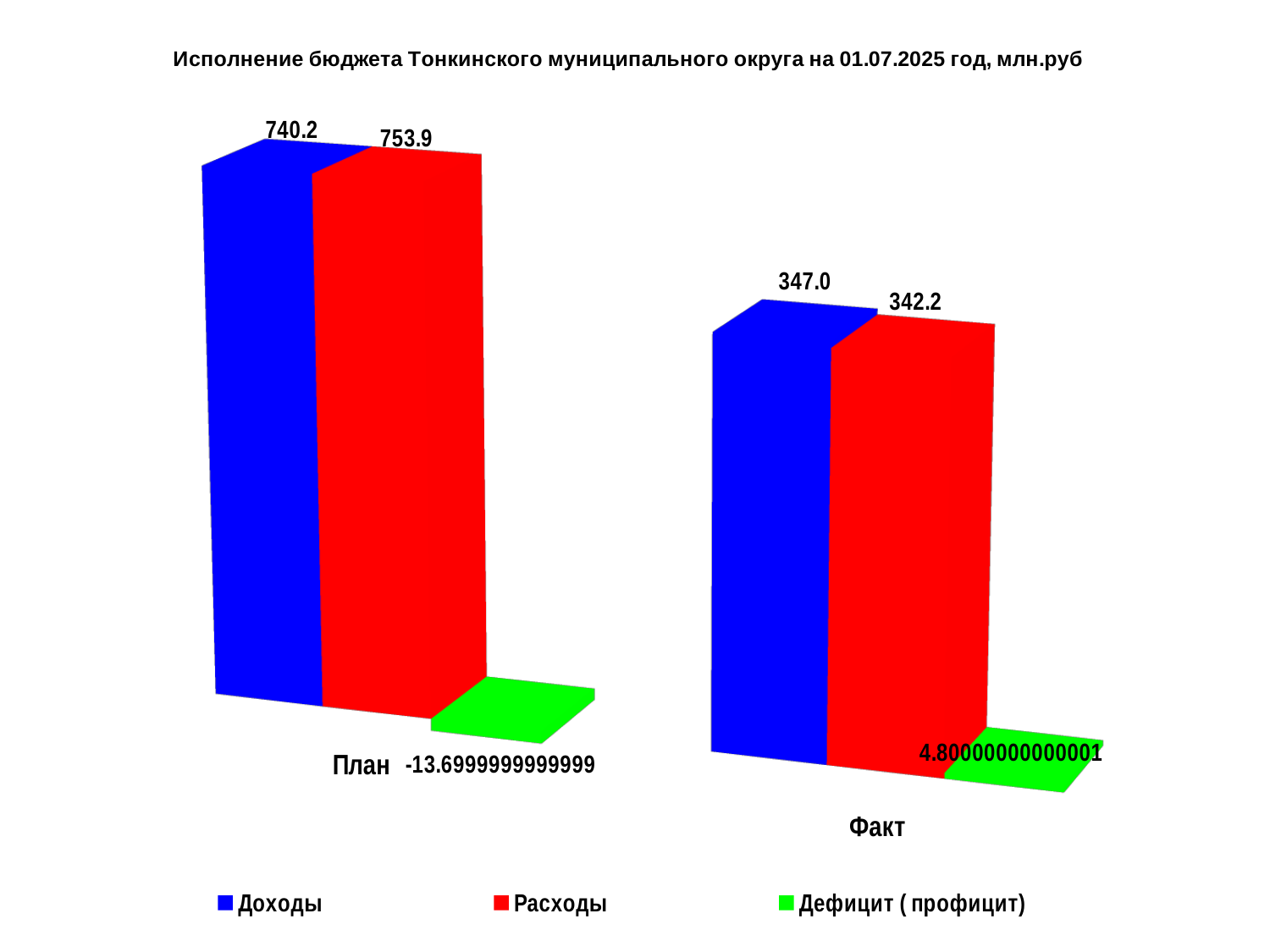
What is the difference between Расходы and Доходы for План? 13.7 Which is larger for Факт, Доходы or Расходы? Доходы What is the value of Расходы for Факт? 342.2 What is the value of Расходы for План? 753.9 Which is larger for План, Доходы or Расходы? Расходы What is the value of Дефицит (профицит) for План as printed on the slide? -13.6999999999999 What kind of chart is shown on the slide? Bar chart What is the value of Доходы for Факт? 347.0 What is the difference between Доходы for План and Доходы for Факт? 393.2 How many series does the legend list? 3 What is the value of Дефицит (профицит) for Факт as printed on the slide? 4.80000000000001 What is the value of Доходы for План? 740.2